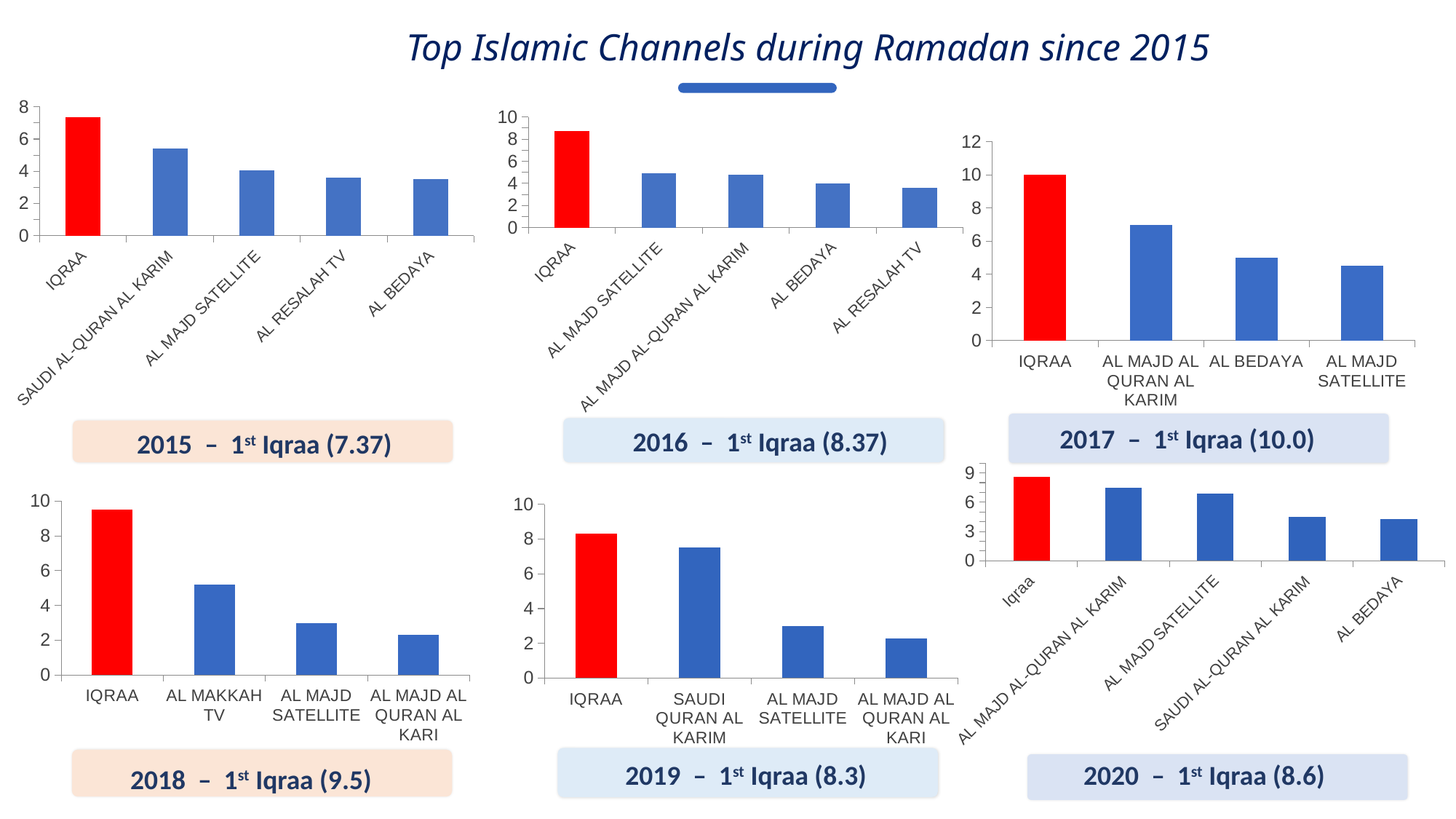
In the 2019 chart, which channel has the highest bar? IQRAA In the 2015 chart, is the value for Saudi Al-Quran Al Karim greater or less than 4? greater In the 2017 chart, what value is given for Iqraa in the caption? 10.0 What type of chart is used for the 2016 data? Bar chart How many channels are shown in the 2017 chart? 4 In the 2020 chart, which channel has the lowest bar? AL BEDAYA What is the difference between Iqraa's value in 2017 (10.0) and in 2015 (7.37)? 2.63 In the 2018 chart, which channel has the lowest bar? AL MAJD AL QURAN AL KARI In the 2018 chart, is the value for Al Majd Satellite greater or less than 4? less In the 2015 chart, what value is given for Iqraa in the caption? 7.37 In each chart, what colour is the bar for Iqraa? Red Which is larger: Iqraa's value in the 2018 chart or in the 2019 chart? 2018